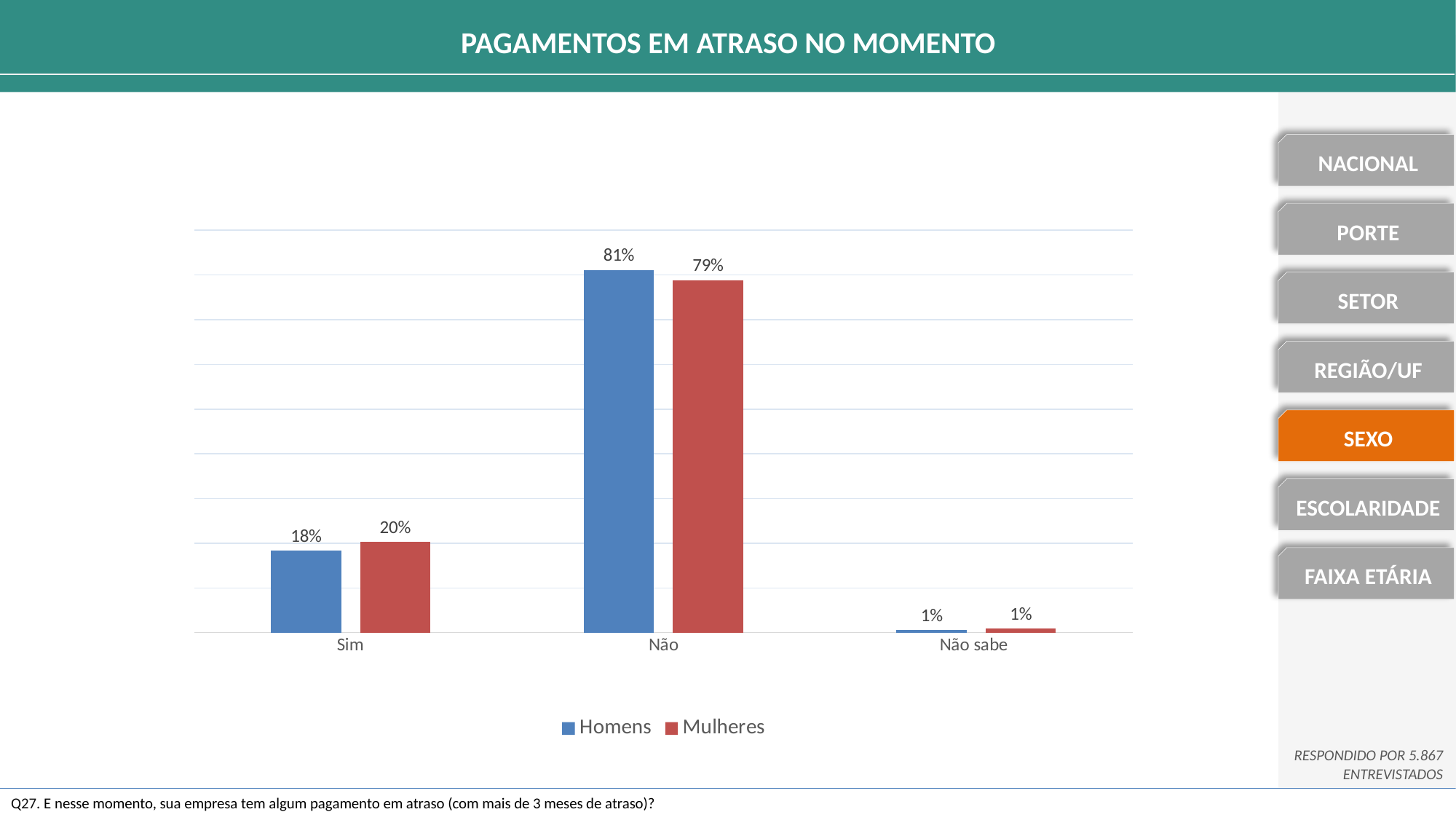
Which category has the highest value for Homens? Não What is the value for Homens in the Não category? 81% What is the difference between Homens and Mulheres in the Não category? 2% What kind of chart is shown on the slide? Bar chart How many series does the legend list? 2 What is the title of the chart? PAGAMENTOS EM ATRASO NO MOMENTO What is the value for Mulheres in the Não category? 79% In the Sim category, which series has the larger value, Homens or Mulheres? Mulheres What is the value for Mulheres in the Sim category? 20% Which category has the lowest value for Mulheres? Não sabe What is the value for Homens in the Sim category? 18% How many categories are shown on the x axis? 3